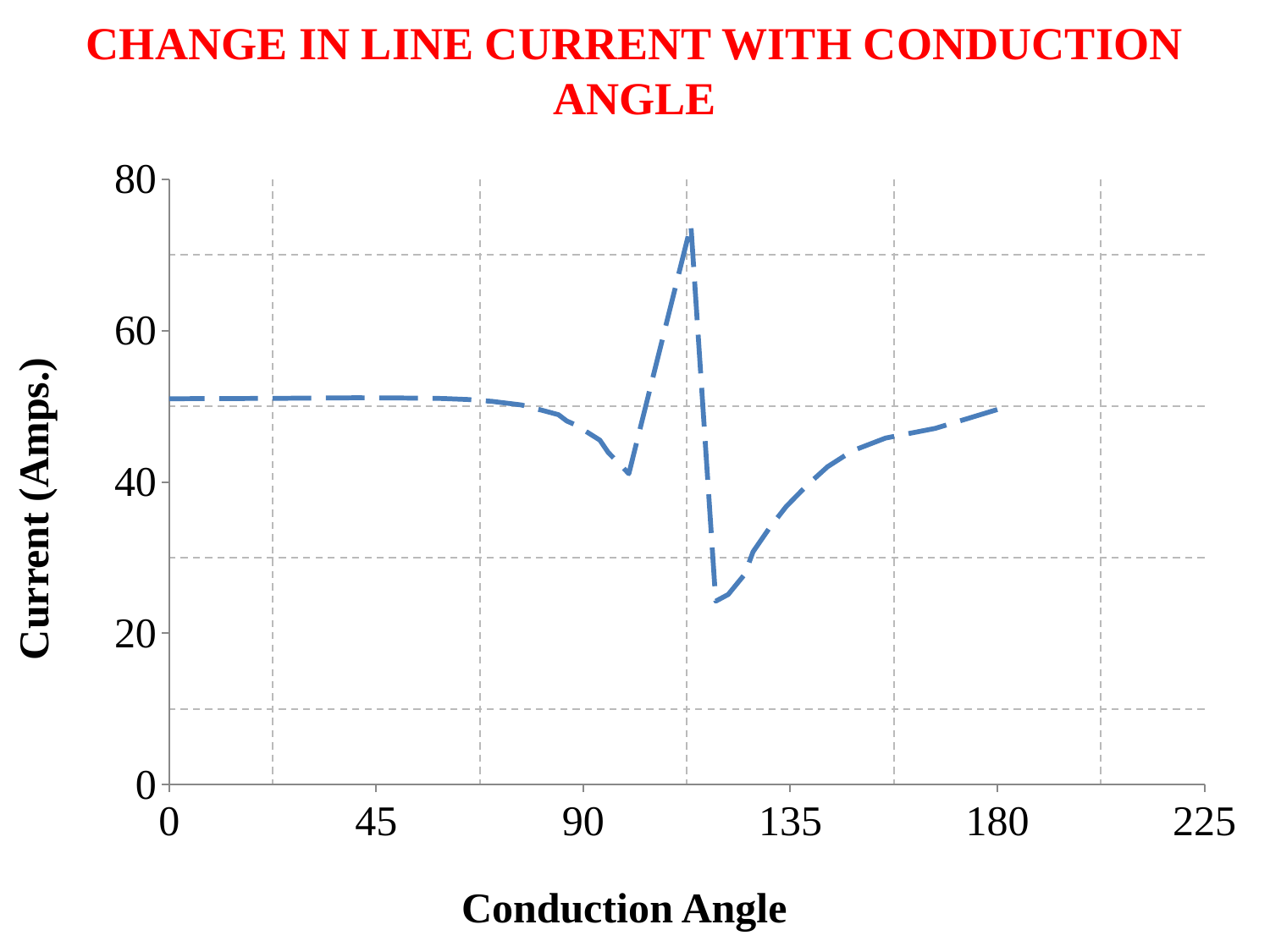
Is the peak current on the chart greater or less than 60? greater Is the lowest current on the chart greater or less than 30? less Is the current at a conduction angle of 45 greater or less than 60? less What kind of chart is shown on the slide? line chart Does the current rise or fall between conduction angles of 135 and 180? rise Which is larger, the current at a conduction angle of 0 or the current at a conduction angle of 135? 0 What is the title of the chart? CHANGE IN LINE CURRENT WITH CONDUCTION ANGLE What is the highest value shown on the y axis? 80 What is the label of the y axis? Current (Amps.)